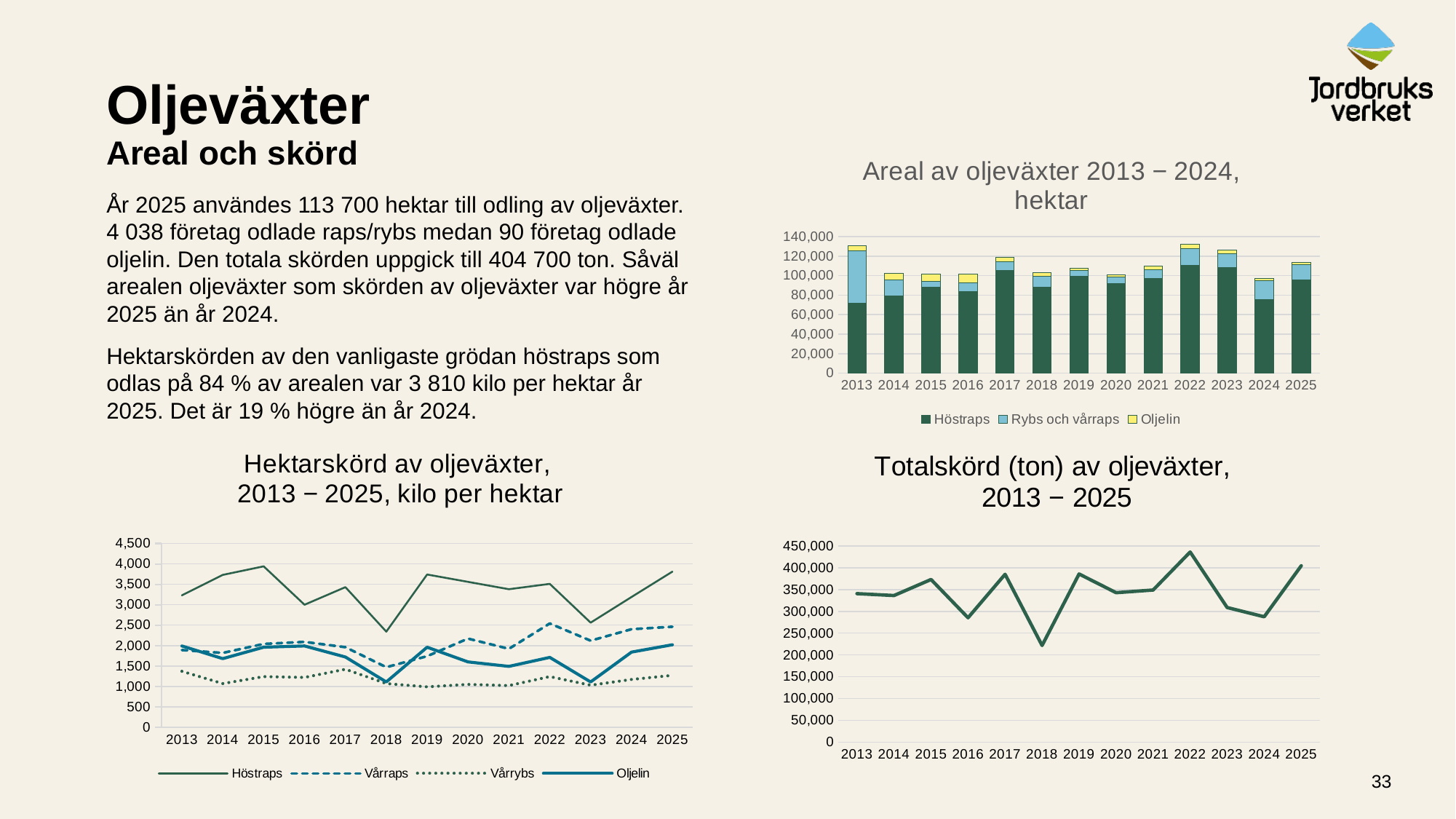
In the "Totalskörd (ton) av oljeväxter" chart, which year has the highest value? 2022 How many series does the legend of the "Hektarskörd av oljeväxter" chart list? 4 In the "Areal av oljeväxter" chart, which year has the lowest Höstraps area? 2013 How many series does the legend of the "Areal av oljeväxter" chart list? 3 In the "Hektarskörd av oljeväxter" chart, which is higher in 2022, Vårraps or Vårrybs? Vårraps In the "Hektarskörd av oljeväxter" chart, which year has the lowest Höstraps value? 2018 How many years are plotted in the "Totalskörd (ton) av oljeväxter" chart? 13 In the "Areal av oljeväxter" chart, is the Höstraps value for 2018 greater or less than 100,000? less In the "Totalskörd (ton) av oljeväxter" chart, is the value for 2018 greater or less than 250,000? less In the "Hektarskörd av oljeväxter" chart, is the Höstraps value for 2018 greater or less than 2,500? less What kind of chart is "Areal av oljeväxter 2013 − 2024, hektar"? Stacked bar chart